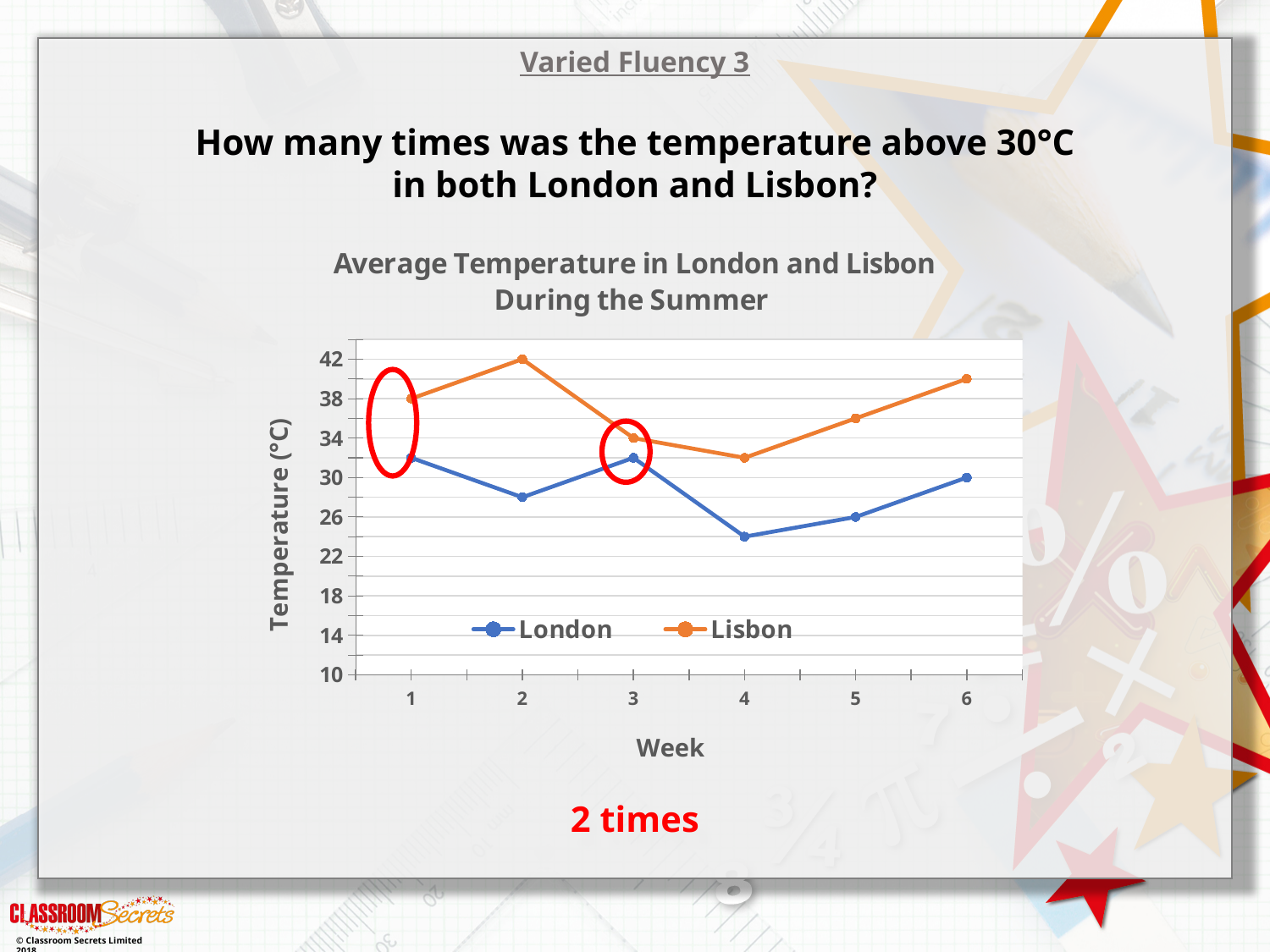
What type of chart is shown on the slide? line chart Is the Lisbon temperature in week 6 greater or less than 38? greater What is the difference between the Lisbon temperature in week 2 and in week 1? 4 In which week was the Lisbon temperature highest? Week 2 What was the average temperature in Lisbon in week 1? 38 Is the London temperature in week 4 greater or less than 26? less What was the average temperature in Lisbon in week 2? 42 What was the average temperature in London in week 5? 26 In which week was the London temperature lowest? Week 4 How many weeks are plotted on the x axis? 6 Does the Lisbon temperature rise or fall from week 4 to week 6? rise How many series does the legend list? 2